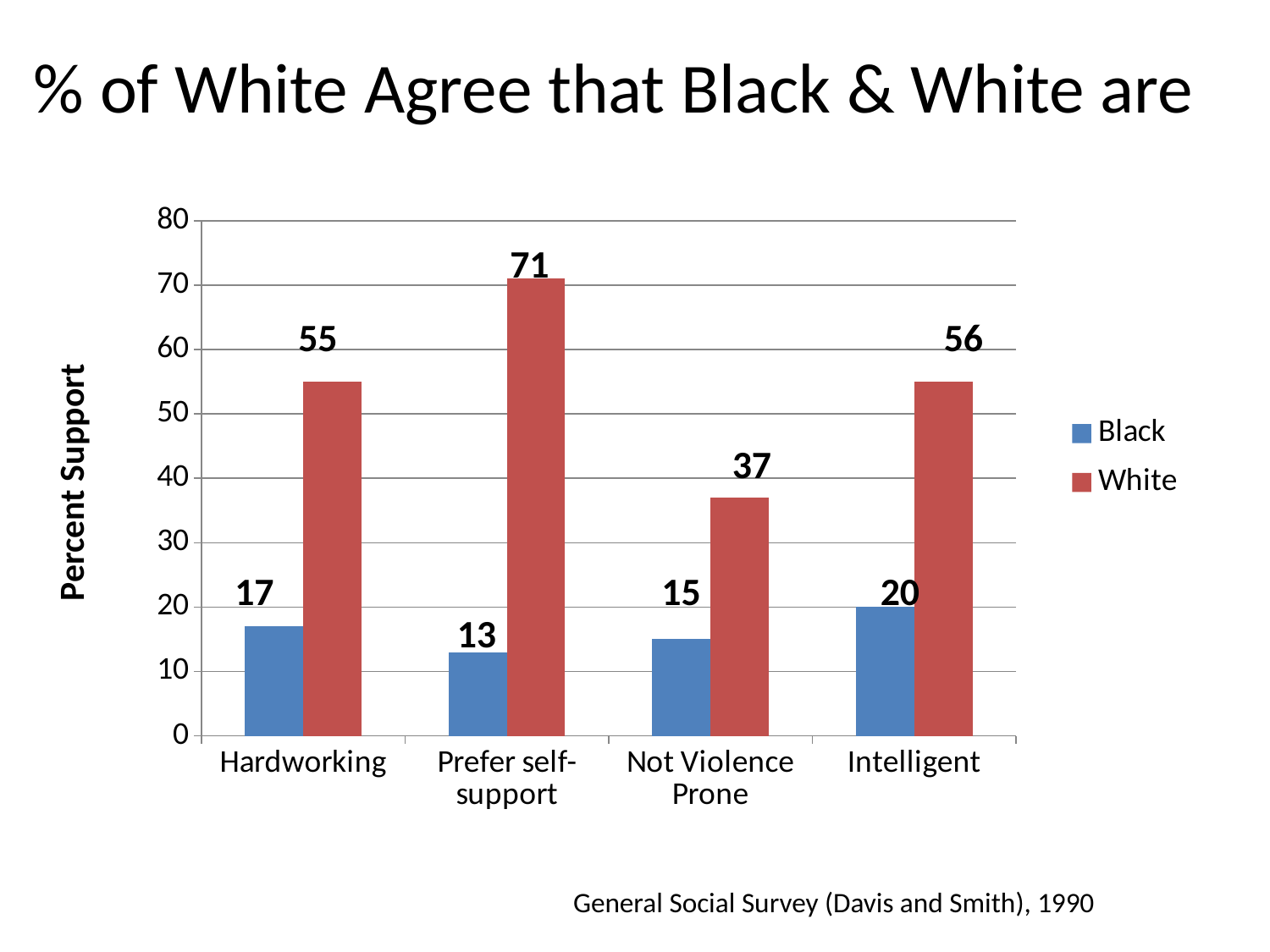
How many series does the legend list? 2 Which category has the lowest value for the Black series? Prefer self-support Which colour represents the White series in the legend? Red What is the value for Black in the Not Violence Prone category? 15 What is the value for White in the Prefer self-support category? 71 Which category has the highest value for the White series? Prefer self-support What is the value for Black in the Intelligent category? 20 What kind of chart is shown on the slide? Bar chart Which is larger: the White value for Not Violence Prone or the White value for Hardworking? Hardworking What is the difference between the White and Black values in the Hardworking category? 38 How many categories are shown on the x axis? 4 What is the label of the vertical axis? Percent Support